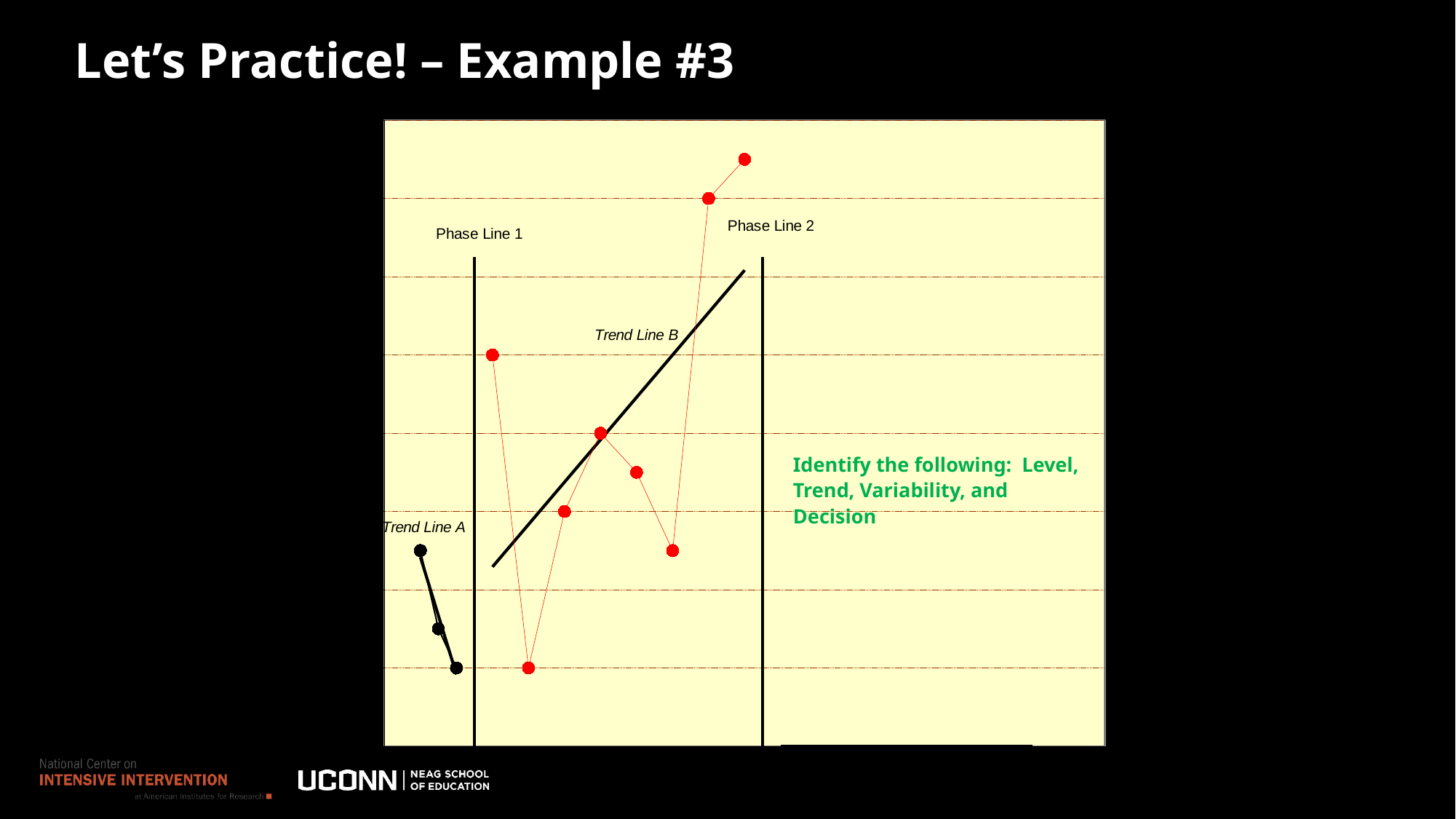
Which red data point between the phase lines is the lowest: the first one or the second one? the second one How many black data points are plotted to the left of Phase Line 1? 3 Does Trend Line B rise or fall from left to right? rise Which red data point between the phase lines is the highest: the first one or the last one? the last one Is the highest red data point the leftmost or the rightmost red point? the rightmost What kind of chart is shown on the slide? line chart What colour are the data points plotted between Phase Line 1 and Phase Line 2? red How many red data points are plotted between Phase Line 1 and Phase Line 2? 8 Do the black data points before Phase Line 1 rise or fall from left to right? fall What are the two vertical phase lines on the chart labelled? Phase Line 1 and Phase Line 2 Does Trend Line A rise or fall from left to right? fall